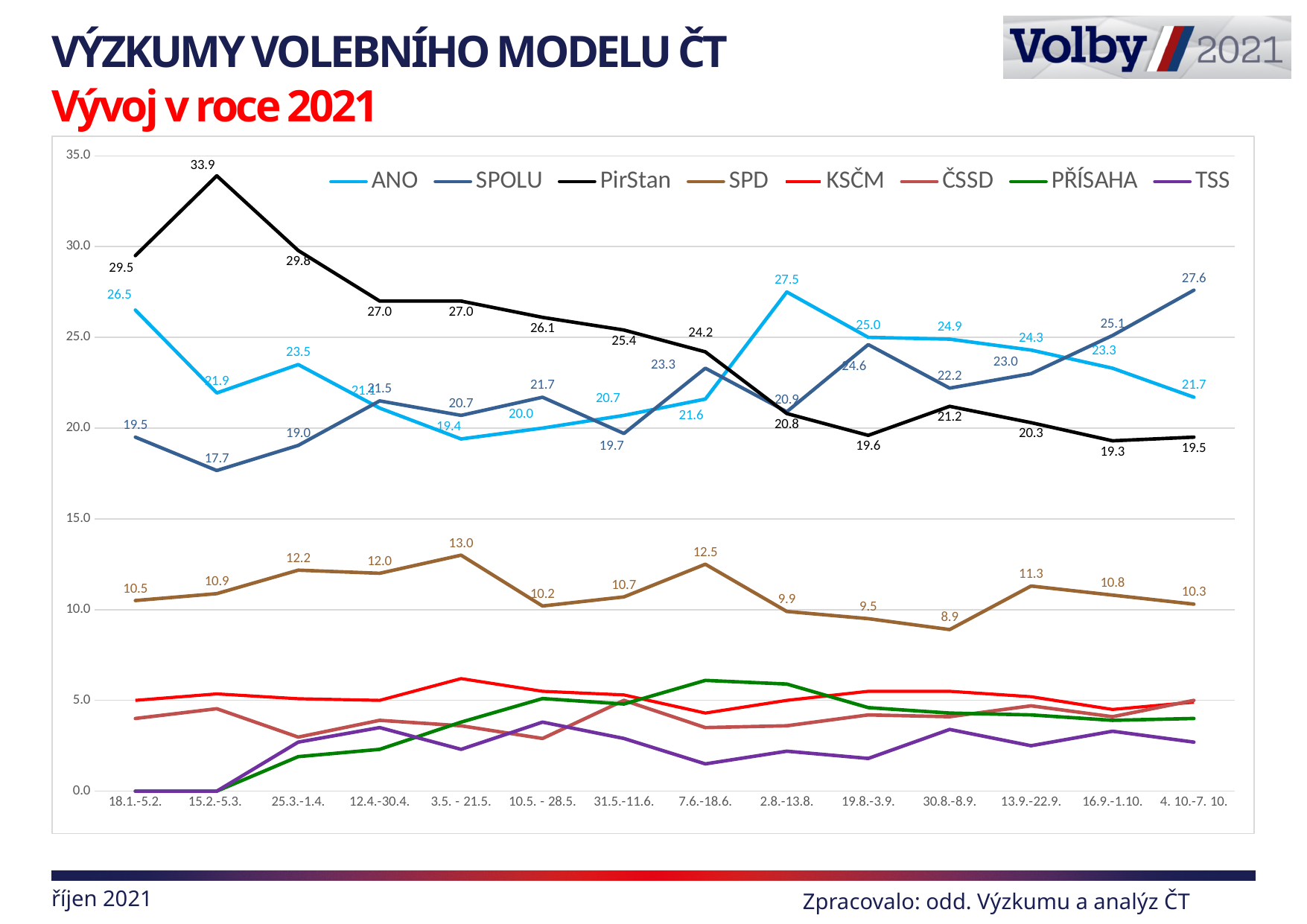
Does the PirStan line rise or fall from the first period to the last period? fall How many survey periods are shown on the x axis? 14 What kind of chart is shown on the slide? line chart In which period does SPD reach its highest value? 3.5. - 21.5. What is the value for PirStan in the period 15.2.-5.3.? 33.9 What is the value for SPOLU in the period 4. 10.-7. 10.? 27.6 How many series does the legend list? 8 What is the value for SPD in the period 30.8.-8.9.? 8.9 In which period does SPOLU have its lowest value? 15.2.-5.3. Is the value for KSČM in the period 3.5. - 21.5. greater or less than 5.0? greater How much higher is the ANO value in 2.8.-13.8. than in 7.6.-18.6.? 5.9 In the period 4. 10.-7. 10., which is larger: ANO or SPOLU? SPOLU